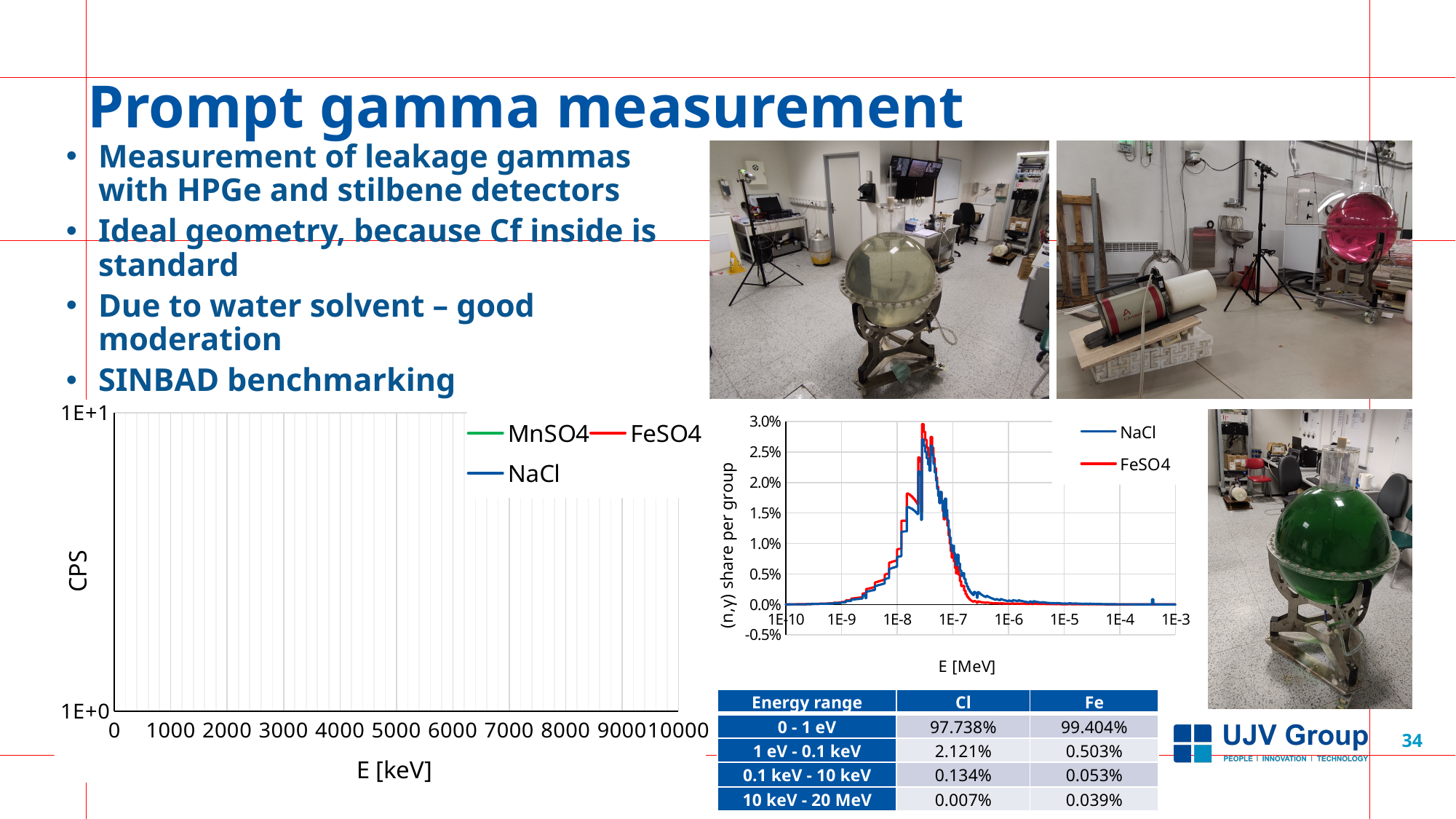
In the chart on the right with x-axis 'E [MeV]', is the value of the NaCl series at 1E-6 MeV greater or less than 0.5%? less In the chart on the right with x-axis 'E [MeV]', which series reaches the higher peak, NaCl or FeSO4? FeSO4 In the chart on the left with y-axis 'CPS', what is the label of the x-axis? E [keV] In the chart on the right with y-axis '(n,γ) share per group', which series are listed in the legend? NaCl and FeSO4 In the chart on the right with x-axis 'E [MeV]', do the values rise or fall as energy increases from 1E-7 to 1E-6 MeV? fall In the chart on the left with y-axis 'CPS', which series is drawn in red in the legend? FeSO4 What kind of chart is the one on the right with x-axis 'E [MeV]'? line chart In the chart on the right with x-axis 'E [MeV]', is the peak value of the FeSO4 series greater or less than 2.5%? greater In the chart on the right with y-axis '(n,γ) share per group', how many series does the legend list? 2 In the chart on the left with y-axis 'CPS', how many series does the legend list? 3